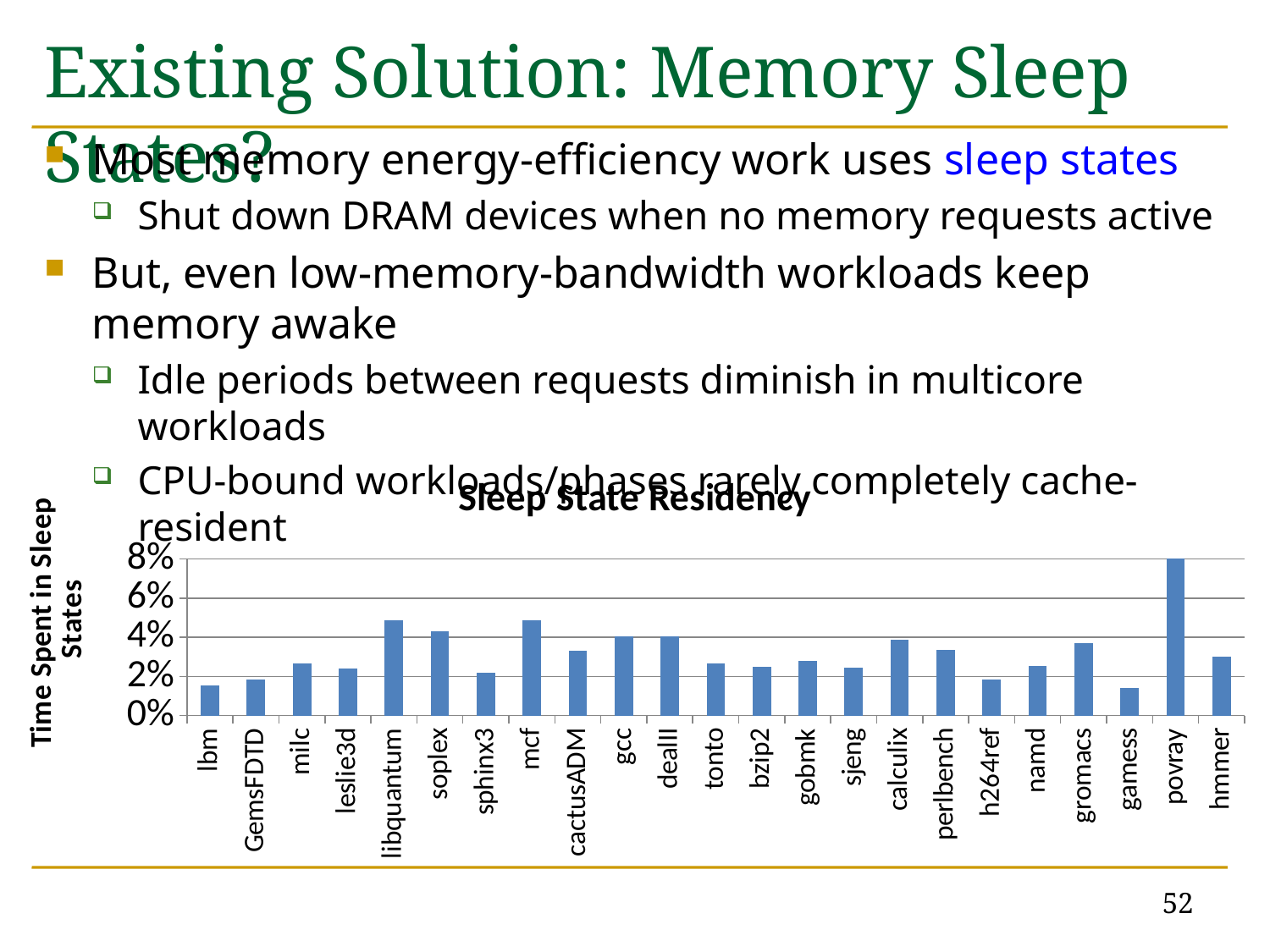
Is the value for cactusADM greater or less than 4%? less What is the label of the vertical axis of the chart? Time Spent in Sleep States What type of chart is shown on the slide? bar chart Which has a larger value, mcf or tonto? mcf Is the value for lbm greater or less than 2%? less Which has a larger value, libquantum or sphinx3? libquantum Is the value for libquantum greater or less than 4%? greater How many benchmarks (categories) are plotted in the chart? 23 What is the title of the chart? Sleep State Residency Which benchmark has the highest time spent in sleep states? povray